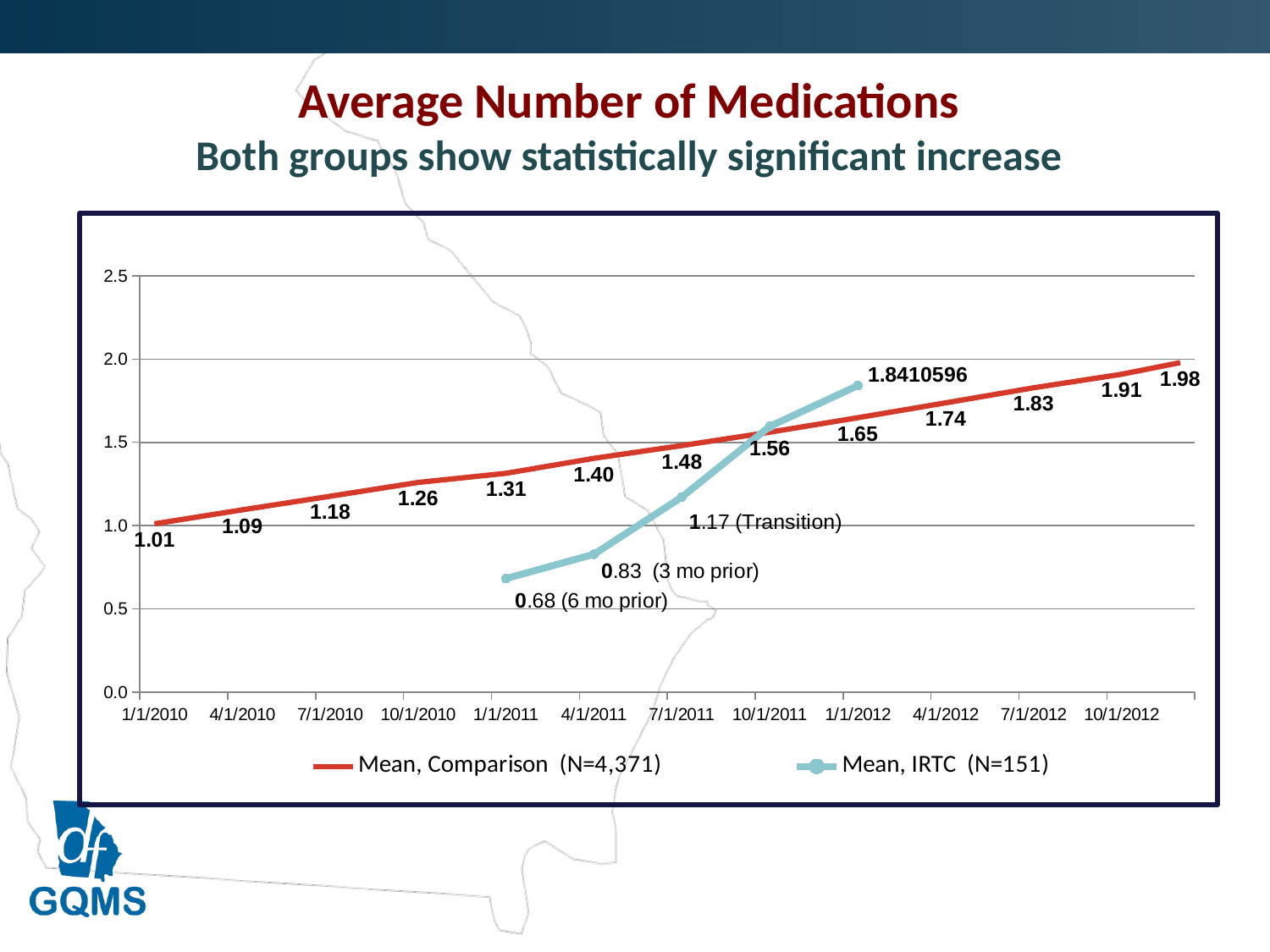
What is the value of the Mean, Comparison series at 1/1/2010? 1.01 What is the value of the Mean, Comparison series at 1/1/2012? 1.65 Does the Mean, Comparison series rise or fall over time? rise What is the value labelled 'Transition' for the Mean, IRTC series? 1.17 What is the lowest labelled value of the Mean, Comparison series? 1.01 What is the value labelled '6 mo prior' for the Mean, IRTC series? 0.68 What is the last labelled value of the Mean, Comparison series? 1.98 What is the difference between the first (1.01) and last (1.98) labelled values of the Mean, Comparison series? 0.97 What is the highest labelled value of the Mean, IRTC series? 1.8410596 Which is larger: the Mean, IRTC value at 1/1/2012 or the Mean, Comparison value at 1/1/2012? Mean, IRTC What kind of chart is shown on the slide? line chart How many series does the legend list? 2